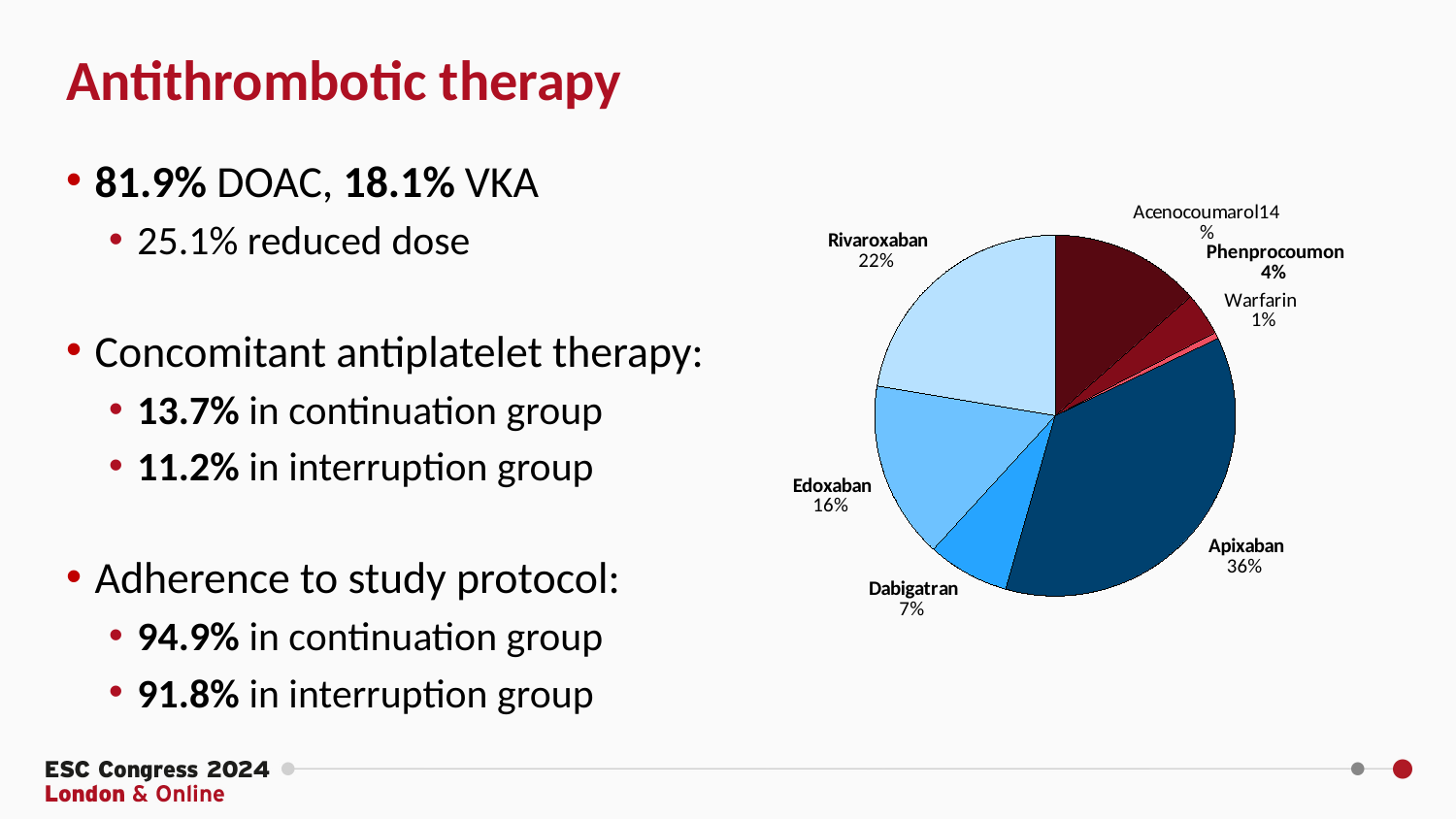
Which has a larger share in the pie chart, Edoxaban or Phenprocoumon? Edoxaban Which drug has the smallest slice of the pie chart? Warfarin What is the value shown for Edoxaban in the pie chart? 16% What kind of chart is shown on the slide? pie chart What is the value shown for Rivaroxaban in the pie chart? 22% What is the combined share of Acenocoumarol, Phenprocoumon and Warfarin in the pie chart? 19% How many slices does the pie chart have? 7 What is the value shown for Dabigatran in the pie chart? 7% What is the difference in percentage points between Apixaban and Rivaroxaban? 14 What share of the pie does Apixaban represent? 36% What is the value shown for Acenocoumarol in the pie chart? 14% Which drug has the largest slice of the pie chart? Apixaban